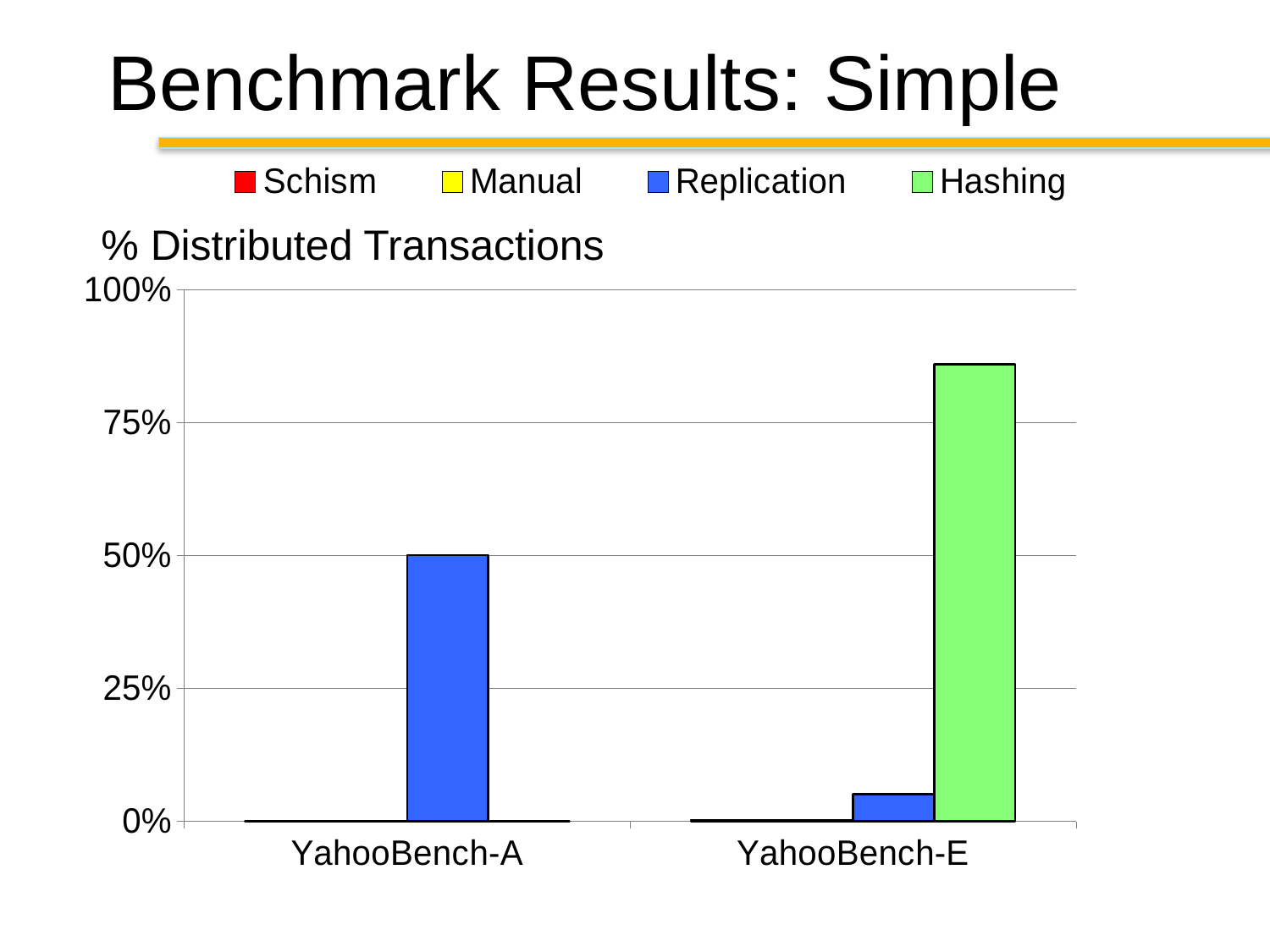
Is the value for Hashing on YahooBench-E greater or less than 75%? greater Is the value for Replication on YahooBench-E greater or less than 25%? less What is the label on the y axis of the chart? % Distributed Transactions Which series has the highest value for YahooBench-A? Replication Is the value for Hashing on YahooBench-E greater or less than 100%? less Which category has the larger Replication value, YahooBench-A or YahooBench-E? YahooBench-A What kind of chart is shown on the slide? bar chart What colour represents the Hashing series in the legend? green How many categories are shown on the x axis? 2 What is the value for Replication on YahooBench-A? 50% How many series does the legend list? 4 Which series has the highest value for YahooBench-E? Hashing